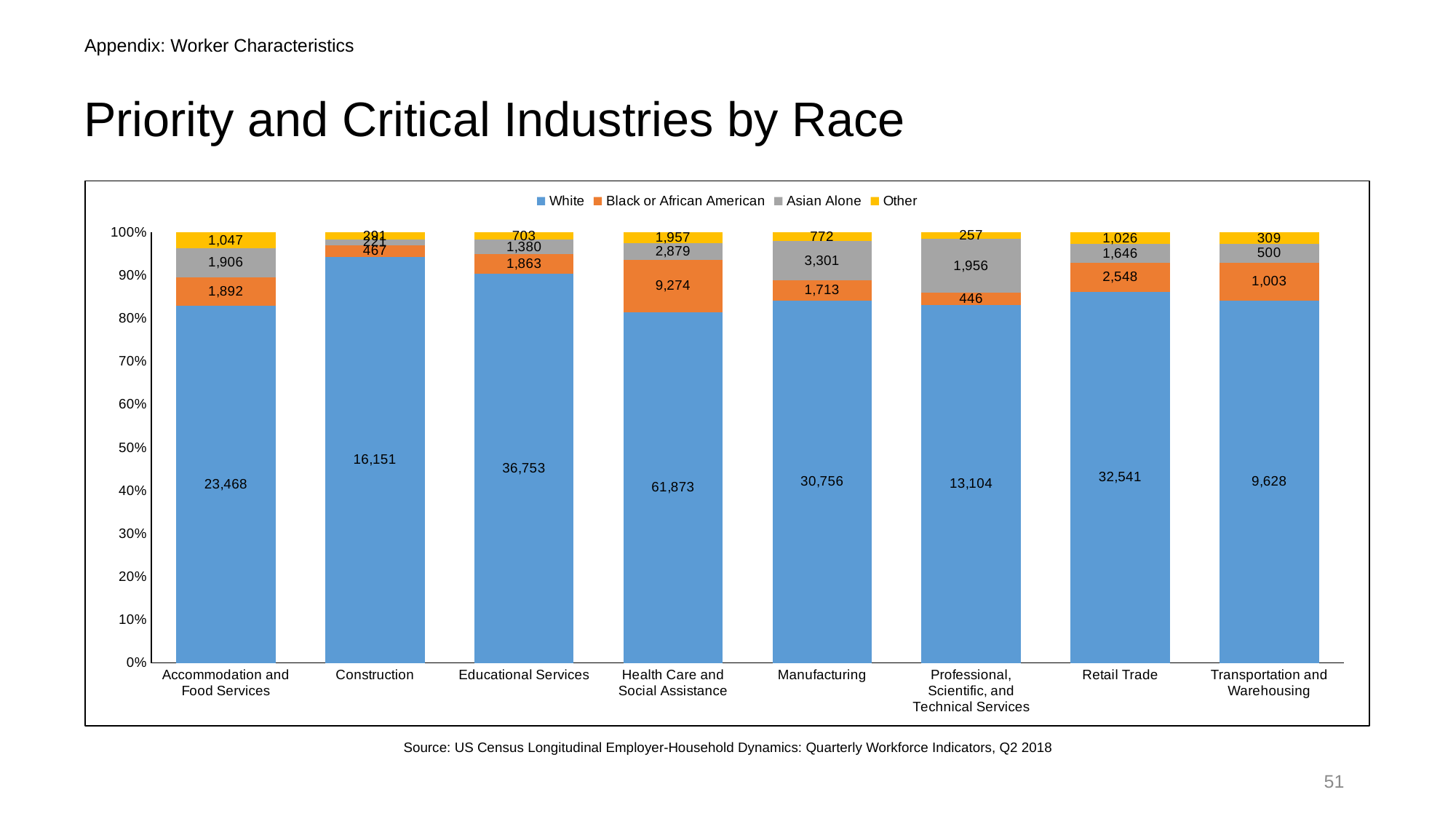
What kind of chart is shown on the slide? Stacked bar chart What is the value for Black or African American in Retail Trade? 2,548 How many series does the legend list? 4 Which industry has the lowest value for White? Transportation and Warehousing Which is larger: the Black or African American value for Health Care and Social Assistance or for Retail Trade? Health Care and Social Assistance What is the value for Asian Alone in Manufacturing? 3,301 What is the value for White in Health Care and Social Assistance? 61,873 What is the value for Other in Accommodation and Food Services? 1,047 Which industry has the highest value for White? Health Care and Social Assistance What is the total of all four series for Transportation and Warehousing? 11,440 How many industries are shown on the x axis? 8 What is the difference between the White values for Educational Services and Manufacturing? 5,997